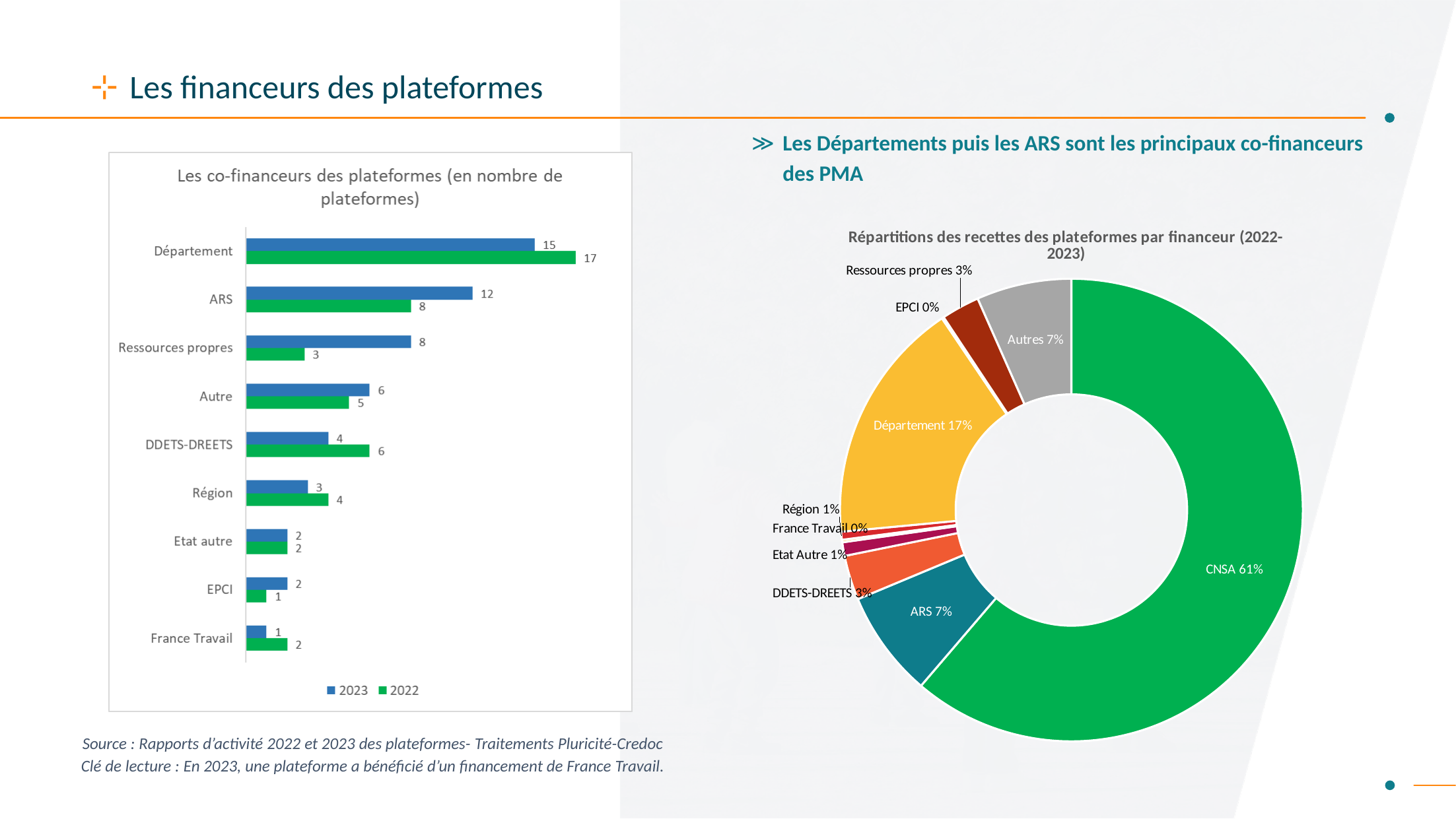
In the doughnut chart 'Répartitions des recettes des plateformes par financeur', what share does Département have? 17% In the bar chart 'Les co-financeurs des plateformes', is the 2023 value for DDETS-DREETS larger or smaller than its 2022 value? smaller What kind of chart is 'Répartitions des recettes des plateformes par financeur (2022-2023)'? doughnut chart How many categories are shown in the bar chart 'Les co-financeurs des plateformes'? 9 In the bar chart 'Les co-financeurs des plateformes', what is the value for Département in 2023? 15 In the bar chart 'Les co-financeurs des plateformes', which category has the lowest value in 2023? France Travail How many series does the legend of the bar chart 'Les co-financeurs des plateformes' list? 2 In the bar chart 'Les co-financeurs des plateformes', what is the difference between the 2023 and 2022 values for Ressources propres? 5 In the doughnut chart 'Répartitions des recettes des plateformes par financeur', what share does CNSA have? 61% In the bar chart 'Les co-financeurs des plateformes', what is the value for ARS in 2022? 8 In the bar chart 'Les co-financeurs des plateformes', which category has the highest value in 2022? Département What kind of chart is 'Les co-financeurs des plateformes'? bar chart